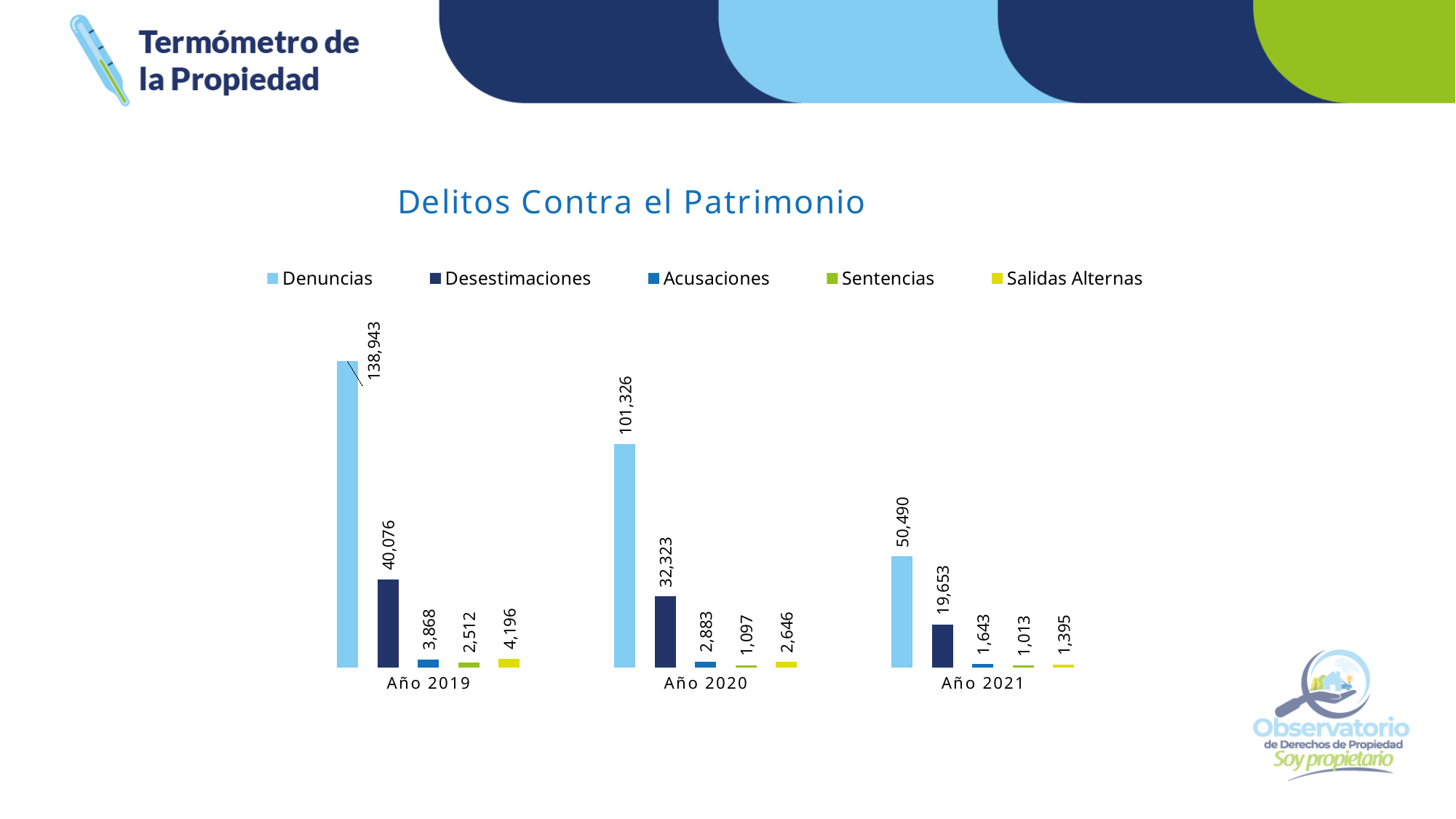
What is the difference between Desestimaciones in Año 2019 and Año 2021? 20,423 Do the Denuncias values rise or fall from Año 2019 to Año 2021? Fall What is the value of Desestimaciones for Año 2020? 32,323 What is the value of Sentencias for Año 2021? 1,013 What is the value of Salidas Alternas for Año 2019? 4,196 In Año 2020, which is larger: Sentencias or Salidas Alternas? Salidas Alternas What kind of chart is shown on the slide? Bar chart What is the difference between Denuncias in Año 2019 and Año 2020? 37,617 How many series does the legend list? 5 What is the value of Denuncias for Año 2019? 138,943 Which year has the highest value for Denuncias? Año 2019 Which year has the lowest value for Acusaciones? Año 2021